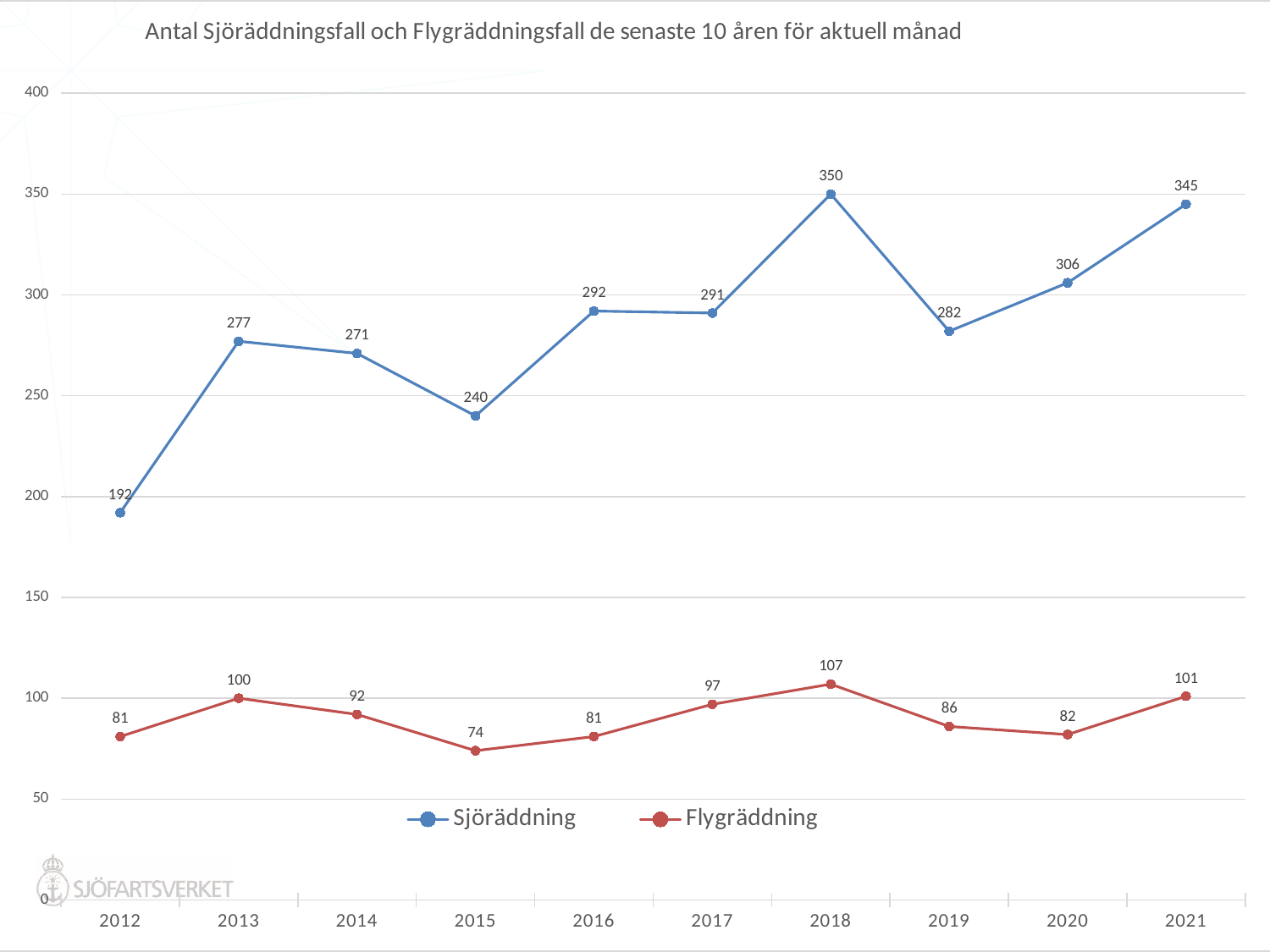
Is the Sjöräddning value for 2015 greater or less than 250? less What is the Flygräddning value for 2015? 74 What is the difference between the Sjöräddning values for 2021 and 2020? 39 What is the Sjöräddning value for 2018? 350 How many years are shown on the x axis? 10 How many series does the legend list? 2 Which year has the lowest Sjöräddning value? 2012 Which year has the highest Flygräddning value? 2018 Which is larger, the Flygräddning value for 2013 or for 2021? 2021 Which series is drawn in red? Flygräddning What is the Sjöräddning value for 2012? 192 What kind of chart is shown on the slide? line chart